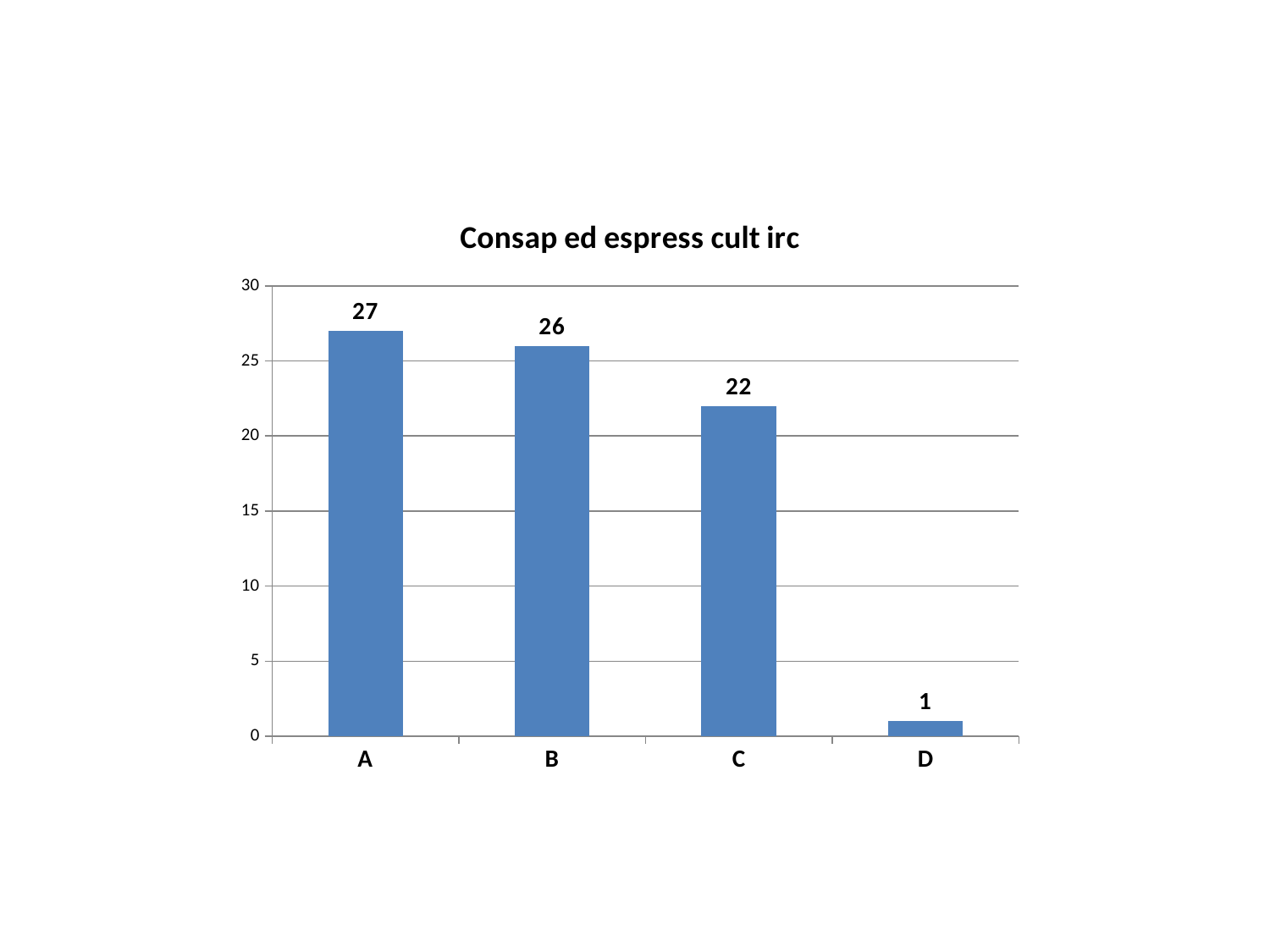
What is the difference between the values for B and D? 25 What is the value for category C? 22 Which is larger, the value for B or the value for C? B What is the title of the chart? Consap ed espress cult irc Which category has the lowest value? D How many categories are shown on the x axis? 4 Is the value for C greater or less than 20? greater What is the difference between the values for A and C? 5 What kind of chart is shown on the slide? bar chart Which category has the highest value? A What is the value for category A? 27 What is the value for category D? 1